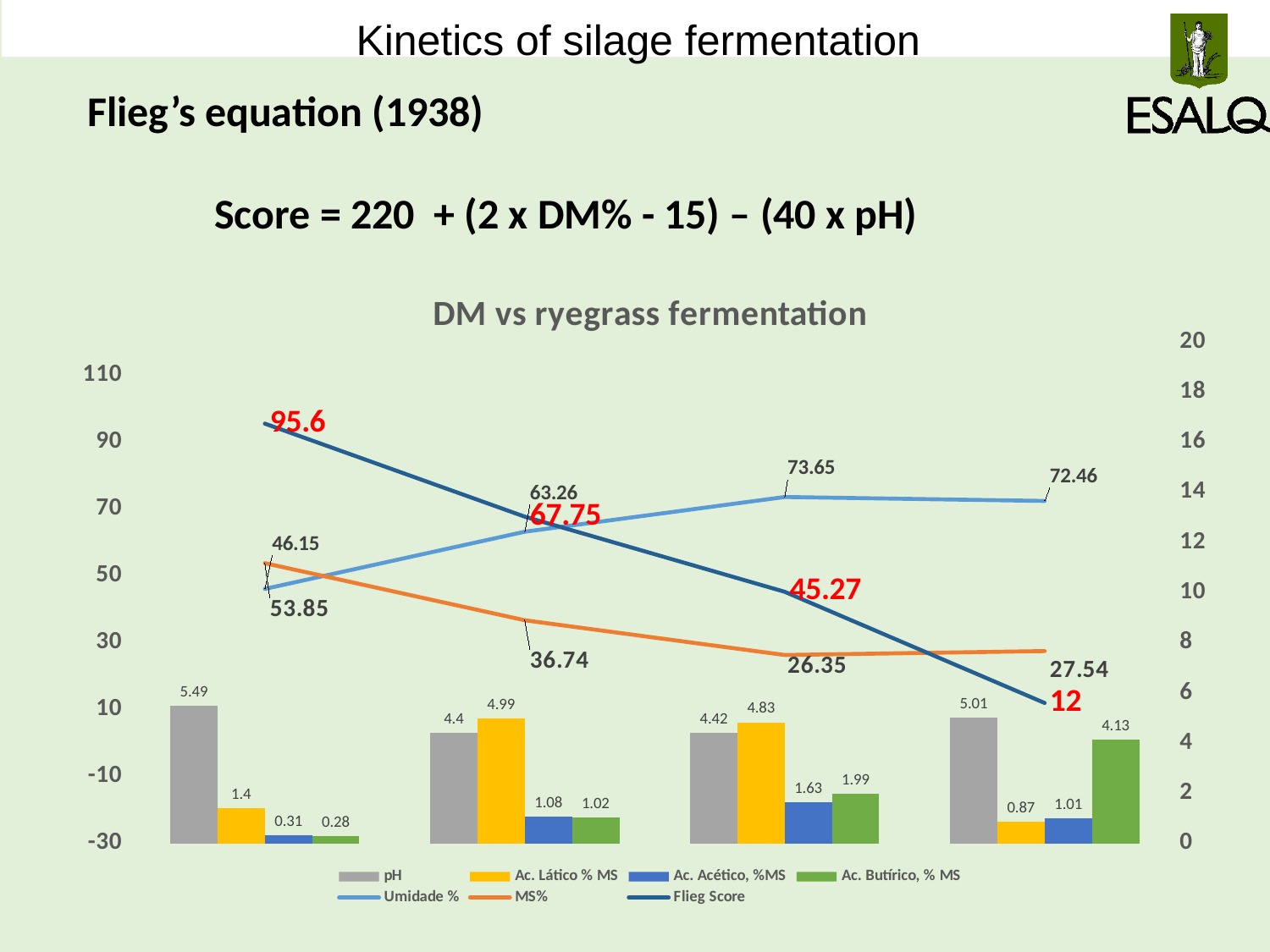
What is the title of the chart? DM vs ryegrass fermentation What is the pH value in the leftmost group of bars? 5.49 What is the lowest MS% value shown on the chart? 26.35 What is the Flieg Score value at the first (leftmost) point? 95.6 What is the highest Umidade % value shown on the chart? 73.65 What is the difference between the first and second Flieg Score values (95.6 and 67.75)? 27.85 Does the Flieg Score line rise or fall from left to right? fall How many groups of bars are plotted along the x axis? 4 What is the Flieg Score value at the last (rightmost) point? 12 What is the Ac. Butírico % MS value in the rightmost group of bars? 4.13 Which is larger in the rightmost group of bars: Ac. Butírico % MS or Ac. Lático % MS? Ac. Butírico % MS How many series does the chart legend list? 7